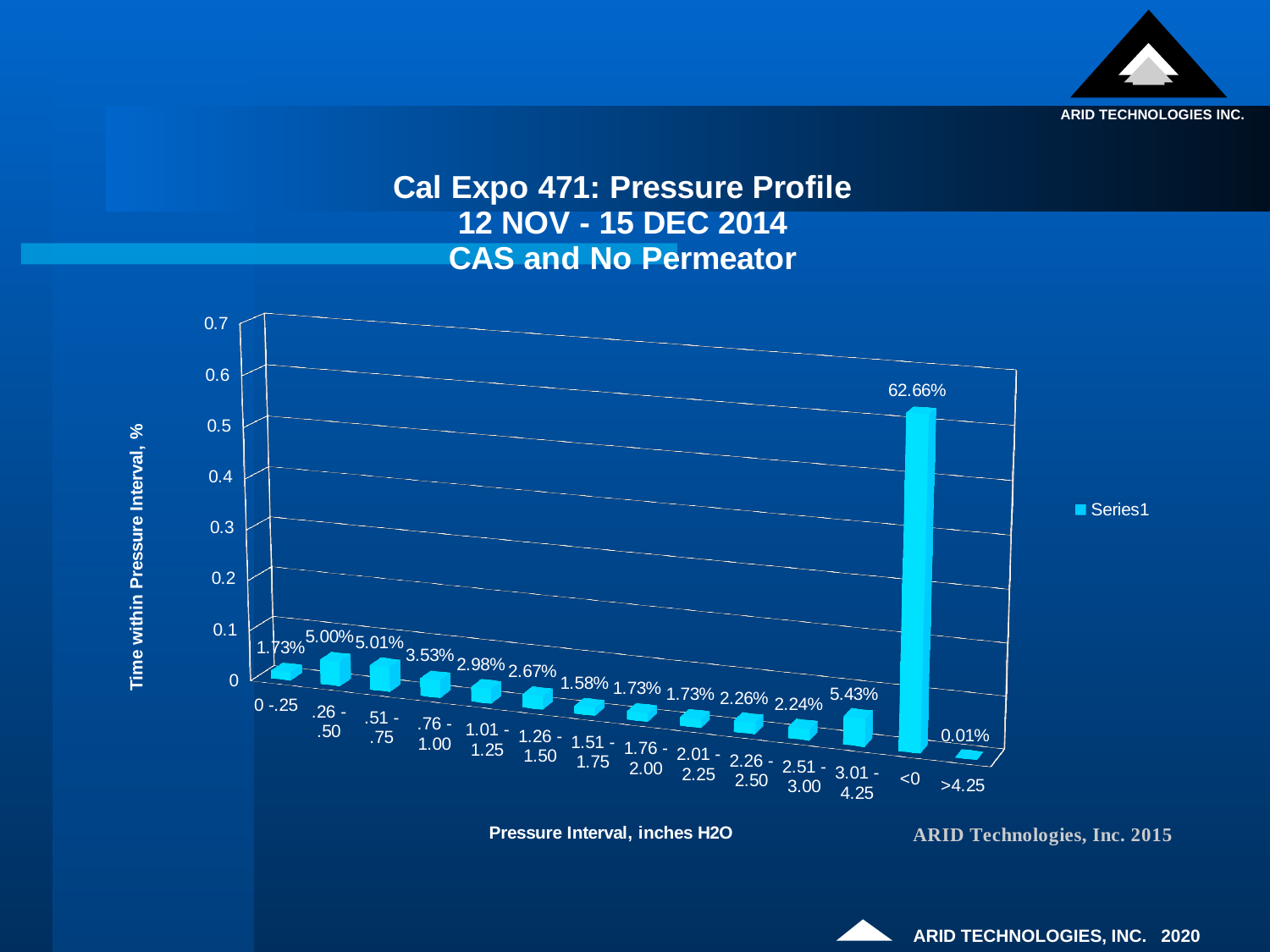
How many pressure intervals are shown on the x axis? 14 Is the bar for the <0 interval greater or less than 0.5 on the y axis? greater What is the value for the 3.01 - 4.25 pressure interval? 5.43% What is the value for the <0 pressure interval? 62.66% What kind of chart is shown on the slide? bar chart Which pressure interval has the highest value? <0 How many series does the legend list? 1 Which is larger, the value for the 3.01 - 4.25 interval or the .76 - 1.00 interval? 3.01 - 4.25 What is the value for the 0 -.25 pressure interval? 1.73% What is the difference between the values for the <0 interval and the 3.01 - 4.25 interval? 57.23% What is the value for the .76 - 1.00 pressure interval? 3.53% Which pressure interval has the lowest value? >4.25